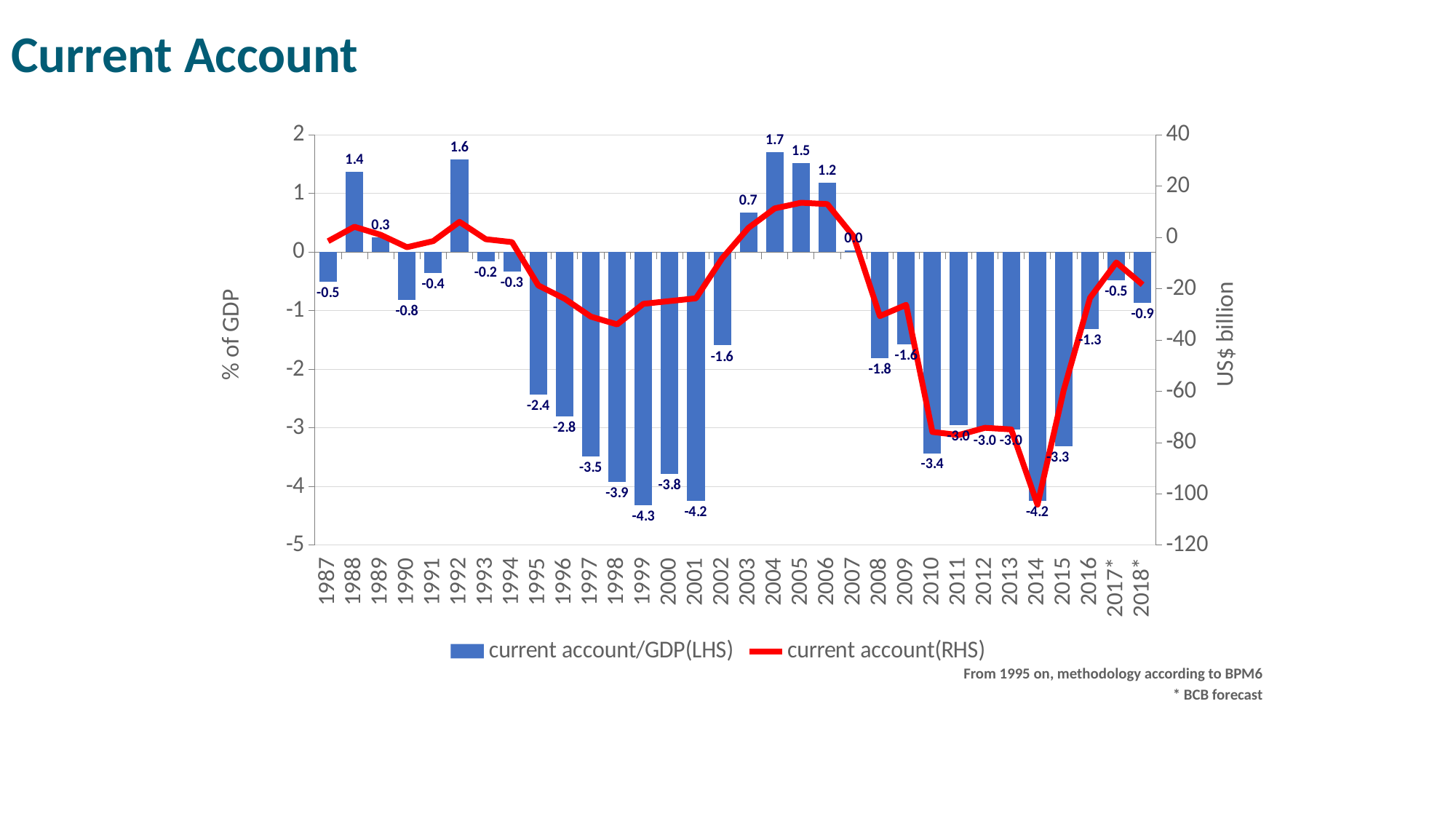
What is the current account/GDP value for 2004? 1.7 What is the current account/GDP value for 2018*? -0.9 How many series does the legend list? 2 What is the difference between the current account/GDP values for 1992 and 1988? 0.2 Is the current account (RHS) value for 2014 greater or less than -80? less What is the label of the right-hand vertical axis? US$ billion Which is larger, the current account/GDP value for 2010 or for 2015? 2015 Is the current account (RHS) value for 2005 greater or less than 0? greater Which year has the highest current account/GDP value? 2004 What is the current account/GDP value for 1999? -4.3 Which year has the lowest current account/GDP value? 1999 How many years are shown on the x axis? 32